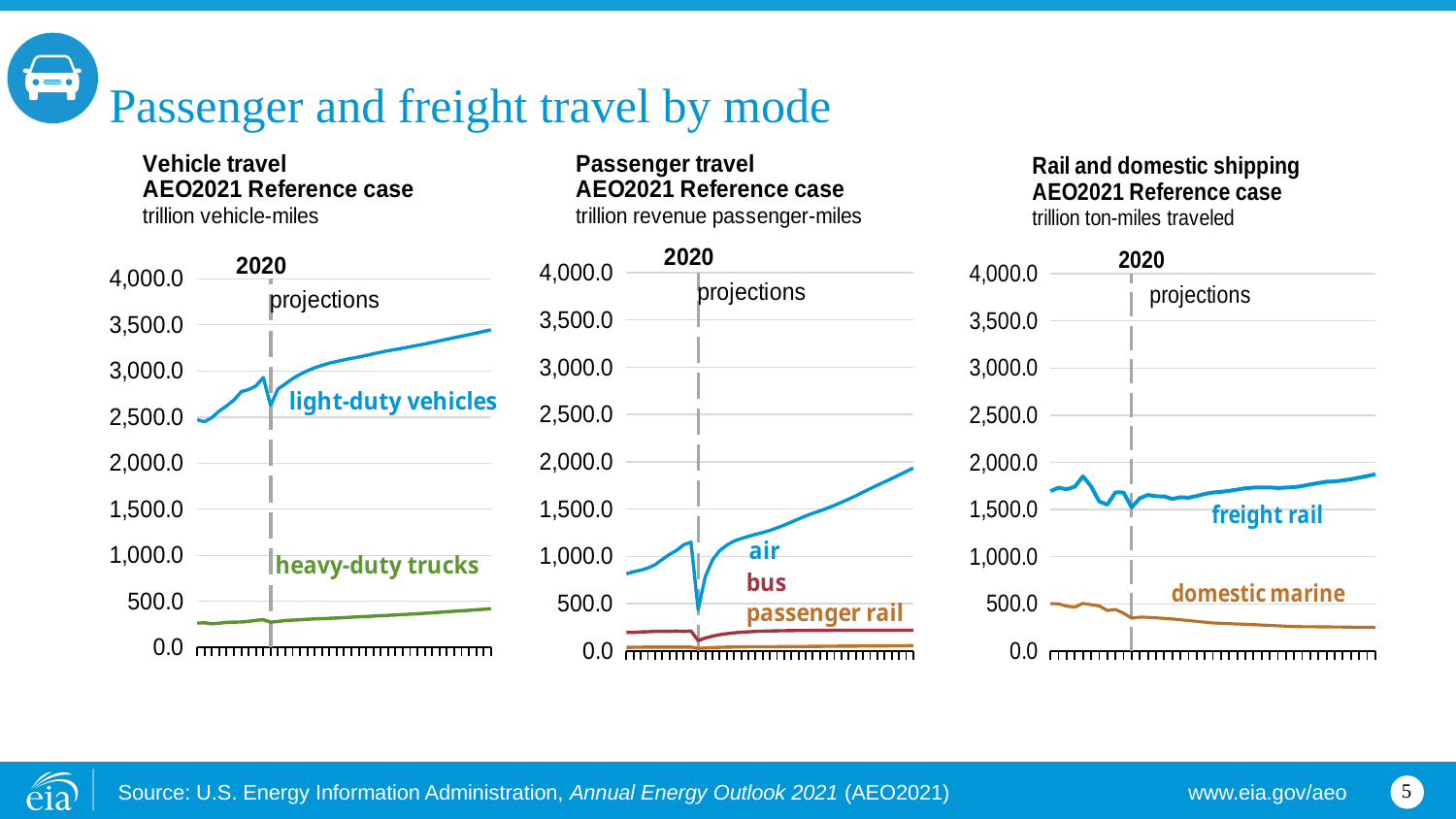
How many series are plotted on the 'Passenger travel' chart in the middle of the slide? 3 On the 'Rail and domestic shipping' chart, does the domestic marine line rise or fall over the projection period? fall What kind of chart is the 'Vehicle travel' chart on the left of the slide? line chart On the 'Passenger travel' chart, does the air line rise or fall over the projection period? rise On the 'Rail and domestic shipping' chart, which series is higher at the end of the projection period, freight rail or domestic marine? freight rail On the 'Vehicle travel' chart, is the value for light-duty vehicles at the end of the projection period greater or less than 3,000.0? greater Which year is marked by the dashed vertical line on each of the three charts? 2020 How many series are plotted on the 'Rail and domestic shipping' chart on the right of the slide? 2 On the 'Vehicle travel' chart, is the value for heavy-duty trucks at the end of the projection period greater or less than 500.0? less On the 'Passenger travel' chart, is the value for bus at the end of the projection period greater or less than 500.0? less What unit is used on the 'Passenger travel' chart in the middle of the slide? trillion revenue passenger-miles